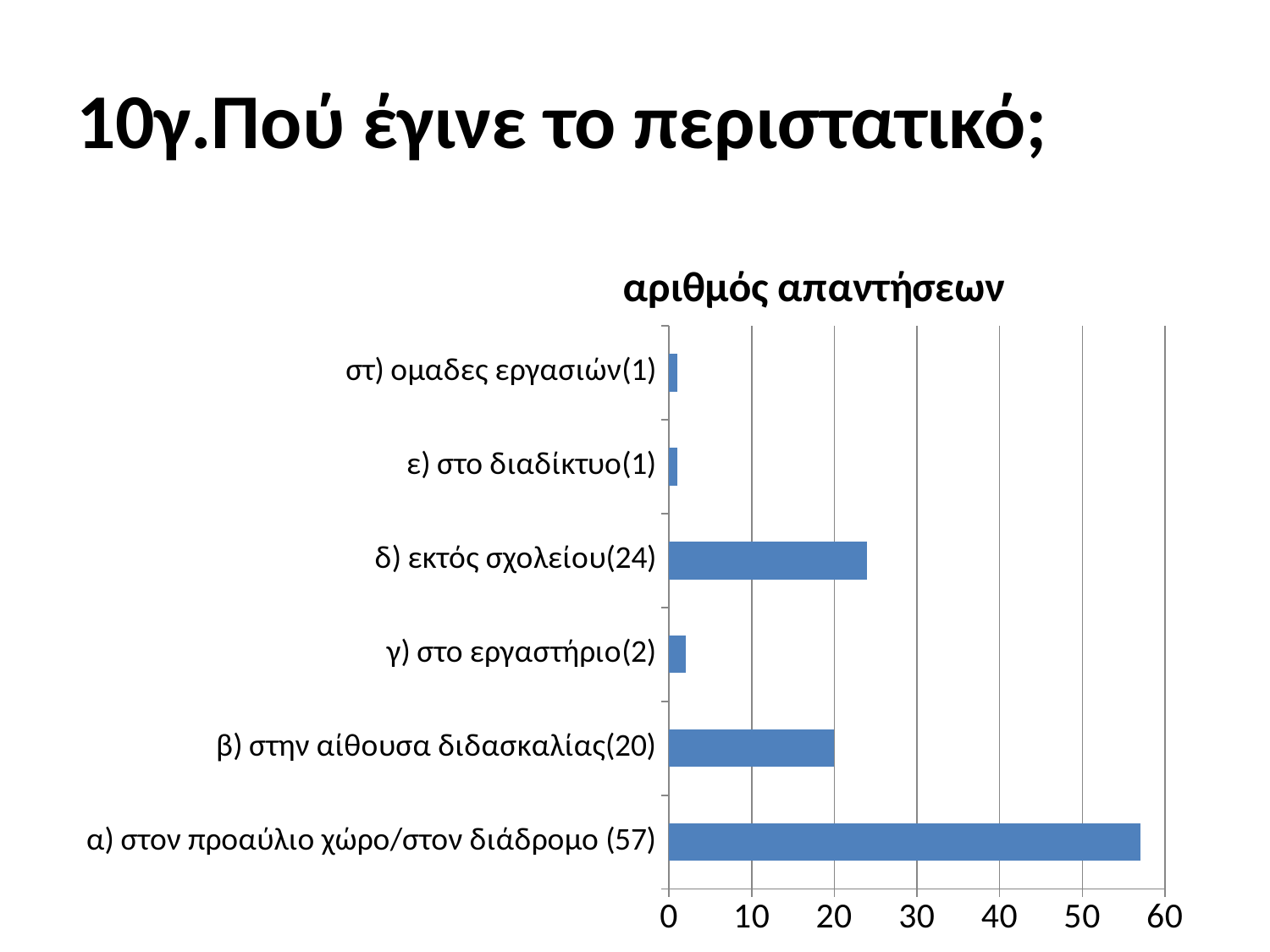
How many responses are shown for "β) στην αίθουσα διδασκαλίας"? 20 Is the value for "α) στον προαύλιο χώρο/στον διάδρομο" greater or less than 50? greater What is the title of the chart? αριθμός απαντήσεων Which has more responses, "δ) εκτός σχολείου" or "β) στην αίθουσα διδασκαλίας"? δ) εκτός σχολείου What is the difference in responses between "δ) εκτός σχολείου" and "β) στην αίθουσα διδασκαλίας"? 4 How many responses are shown for "α) στον προαύλιο χώρο/στον διάδρομο"? 57 How many responses are shown for "δ) εκτός σχολείου"? 24 What is the difference in responses between "α) στον προαύλιο χώρο/στον διάδρομο" and "δ) εκτός σχολείου"? 33 How many responses are shown for "γ) στο εργαστήριο"? 2 How many categories are shown in the chart? 6 Which category has the highest number of responses? α) στον προαύλιο χώρο/στον διάδρομο What kind of chart is shown on the slide? bar chart